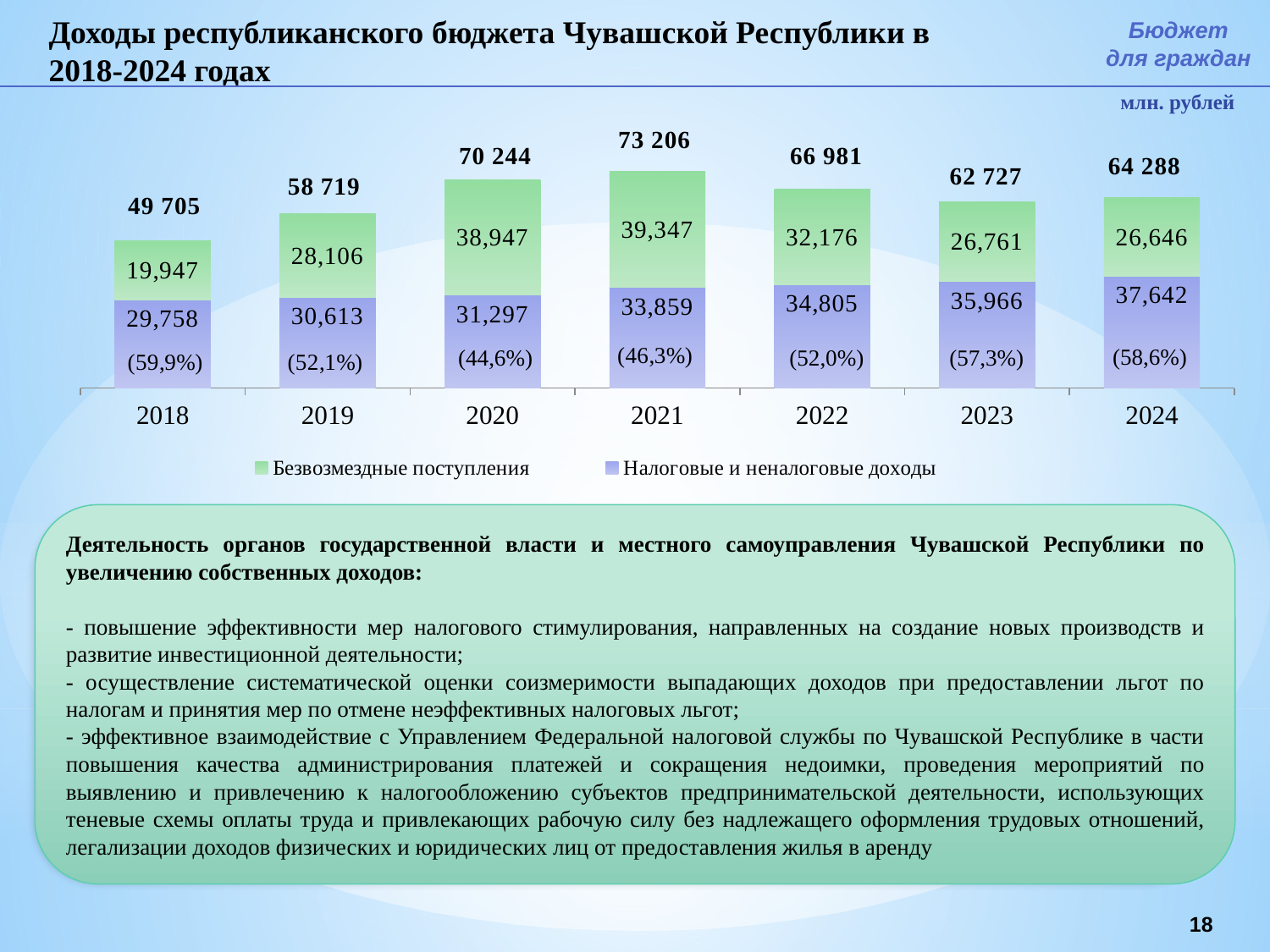
What is the difference between the Налоговые и неналоговые доходы values for 2024 and 2018? 7,884 Which year has the lowest total revenue? 2018 What percentage share is shown in parentheses for 2023? (57,3%) Do the Налоговые и неналоговые доходы values rise or fall from 2018 to 2024? Rise Which is larger in 2022: Безвозмездные поступления or Налоговые и неналоговые доходы? Налоговые и неналоговые доходы How many series does the legend list? 2 Which year has the highest total revenue? 2021 What is the value of Безвозмездные поступления for 2020? 38,947 What is the value of Налоговые и неналоговые доходы for 2021? 33,859 What kind of chart is shown on the slide? Stacked bar chart What is the total revenue shown above the bar for 2019? 58 719 How many years are shown on the x axis? 7